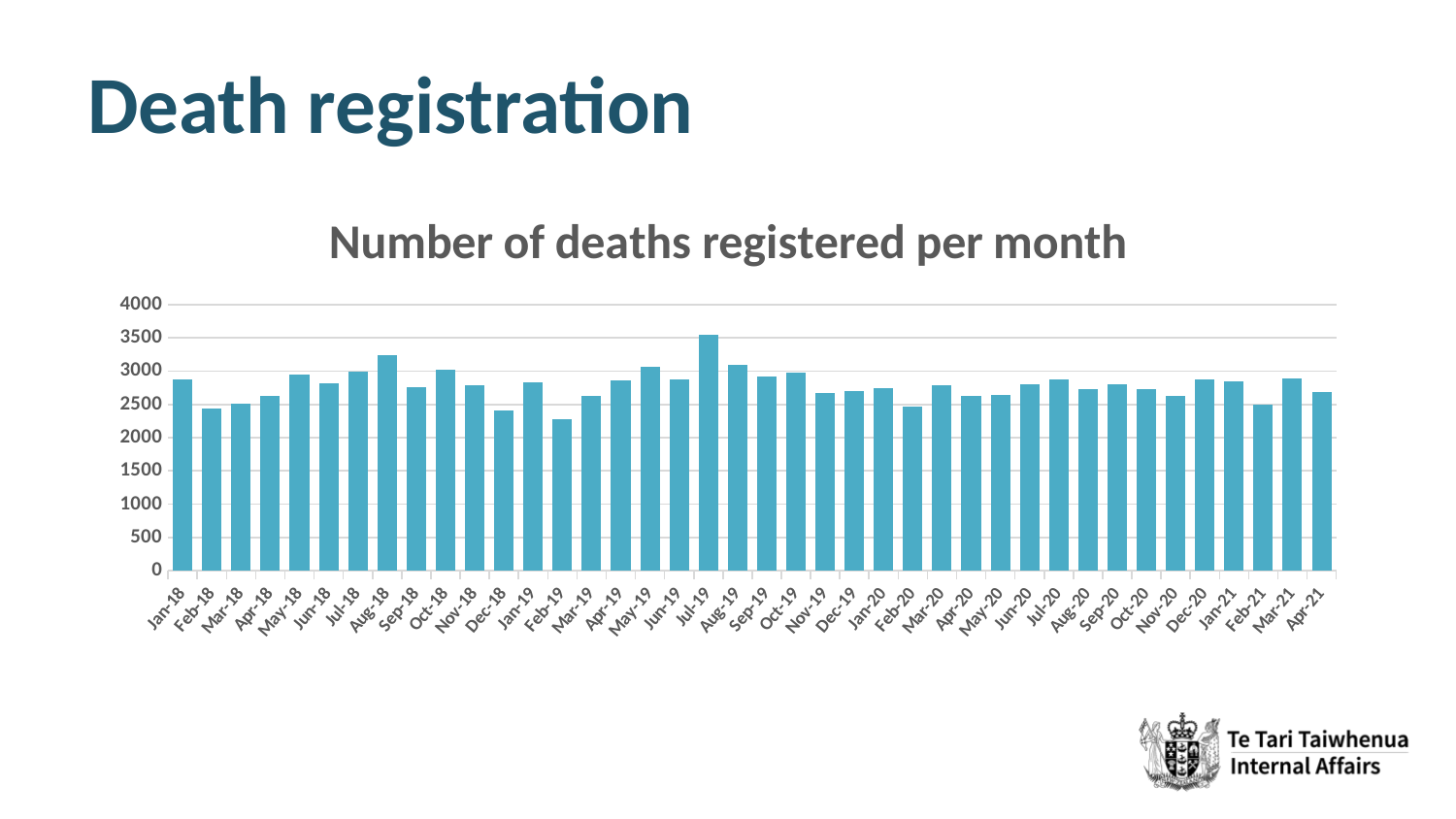
Is the value for Mar-21 greater or less than 2500? greater Which month has the lowest number of deaths registered? Feb-19 Is the value for Jul-19 greater or less than 3000? greater What kind of chart is shown on the slide? Bar chart Which month has the larger value, Aug-18 or Oct-18? Aug-18 Which month has the larger value, Jan-19 or Feb-19? Jan-19 What is the title of the chart? Number of deaths registered per month Which month has the highest number of deaths registered? Jul-19 Is the value for Feb-19 greater or less than 2500? less How many months are plotted on the chart? 40